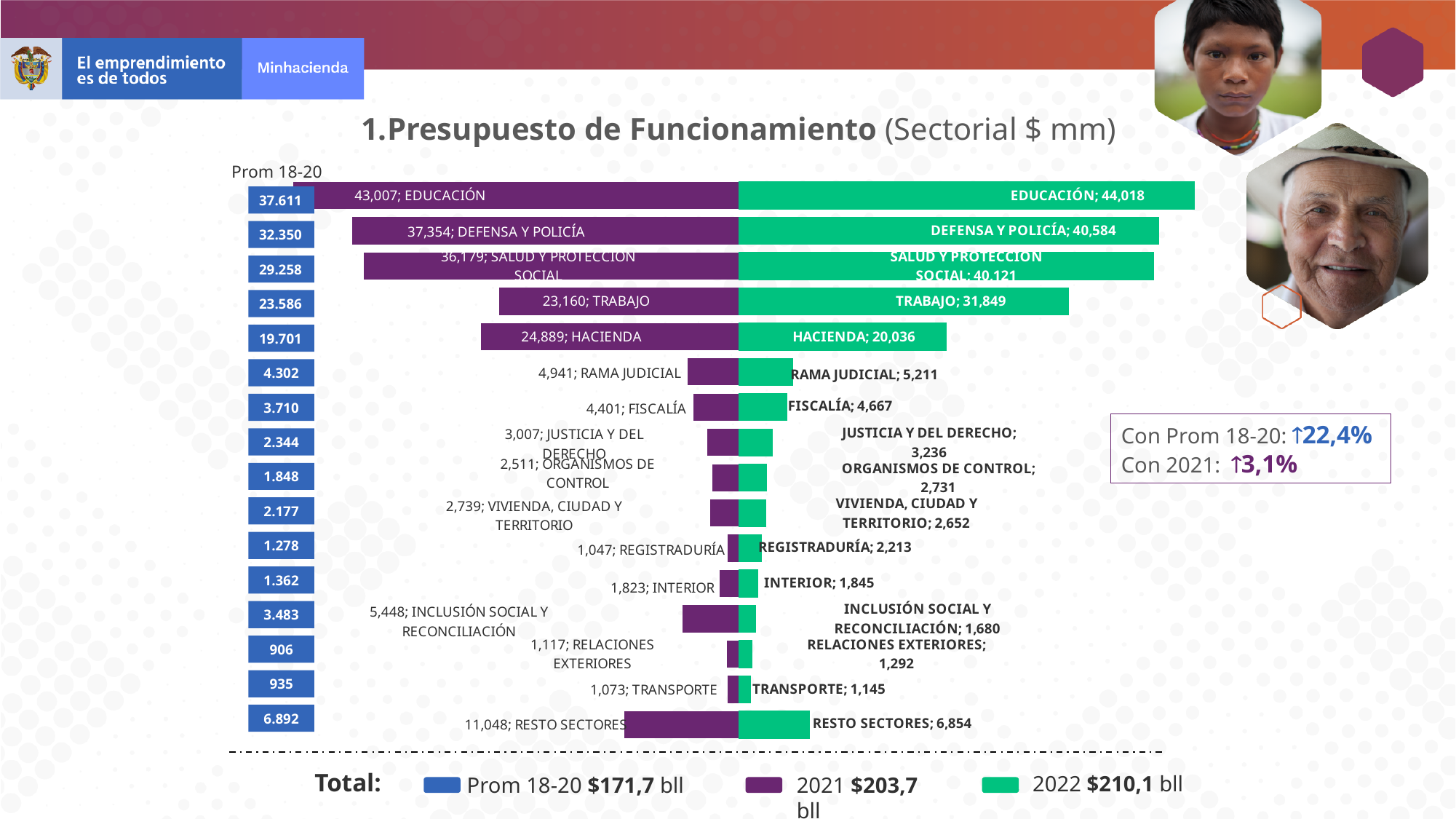
Which sector has the lowest 2021 value? REGISTRADURÍA What is the total for 2022 shown in the legend? $210,1 bll What is the 2022 value for EDUCACIÓN? 44,018 Which is larger for INCLUSIÓN SOCIAL Y RECONCILIACIÓN, the 2021 value or the 2022 value? 2021 How many sectors are shown in the chart? 16 What kind of chart is shown on the slide? Bar chart What is the 2021 value for HACIENDA? 24,889 What is the Prom 18-20 value for TRABAJO? 23.586 How many series does the legend list? 3 What is the difference between the 2022 and 2021 values for TRABAJO? 8,689 Which sector has the highest 2022 value? EDUCACIÓN What is the difference between the 2021 and 2022 values for HACIENDA? 4,853